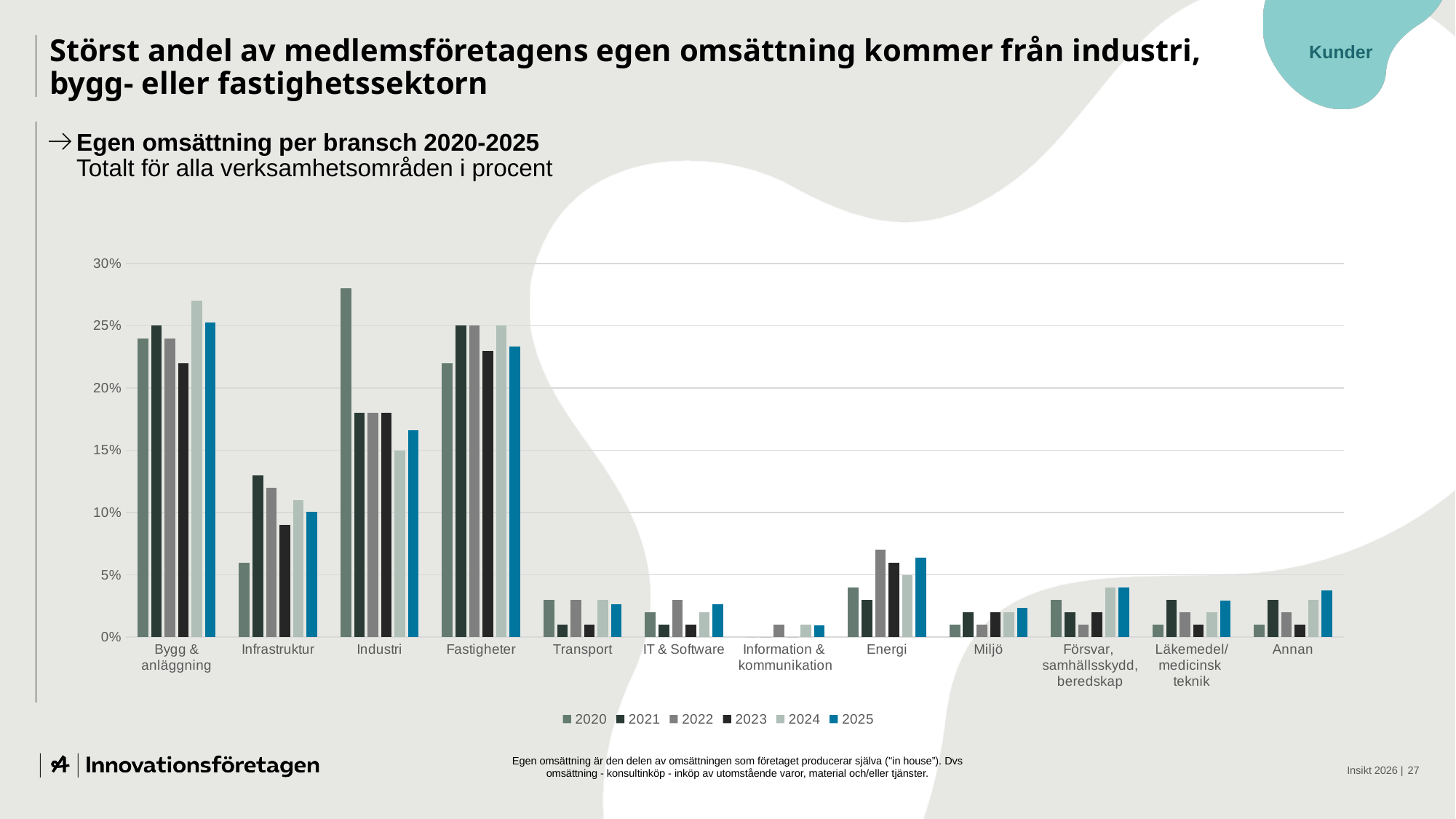
Which category has the highest single bar in the chart? Industri How many series does the legend list? 6 Is the value for Industri in 2020 greater or less than 25%? greater Is the value for Bygg & anläggning in 2024 greater or less than 25%? greater Is the value for Transport in 2020 greater or less than 5%? less Which category has the lowest values overall? Information & kommunikation Which is larger, the 2020 value for Industri or the 2020 value for Bygg & anläggning? Industri What kind of chart is shown on the slide? bar chart Do the values for Industri rise or fall from 2020 to 2024? fall How many industry categories are shown on the x axis? 12